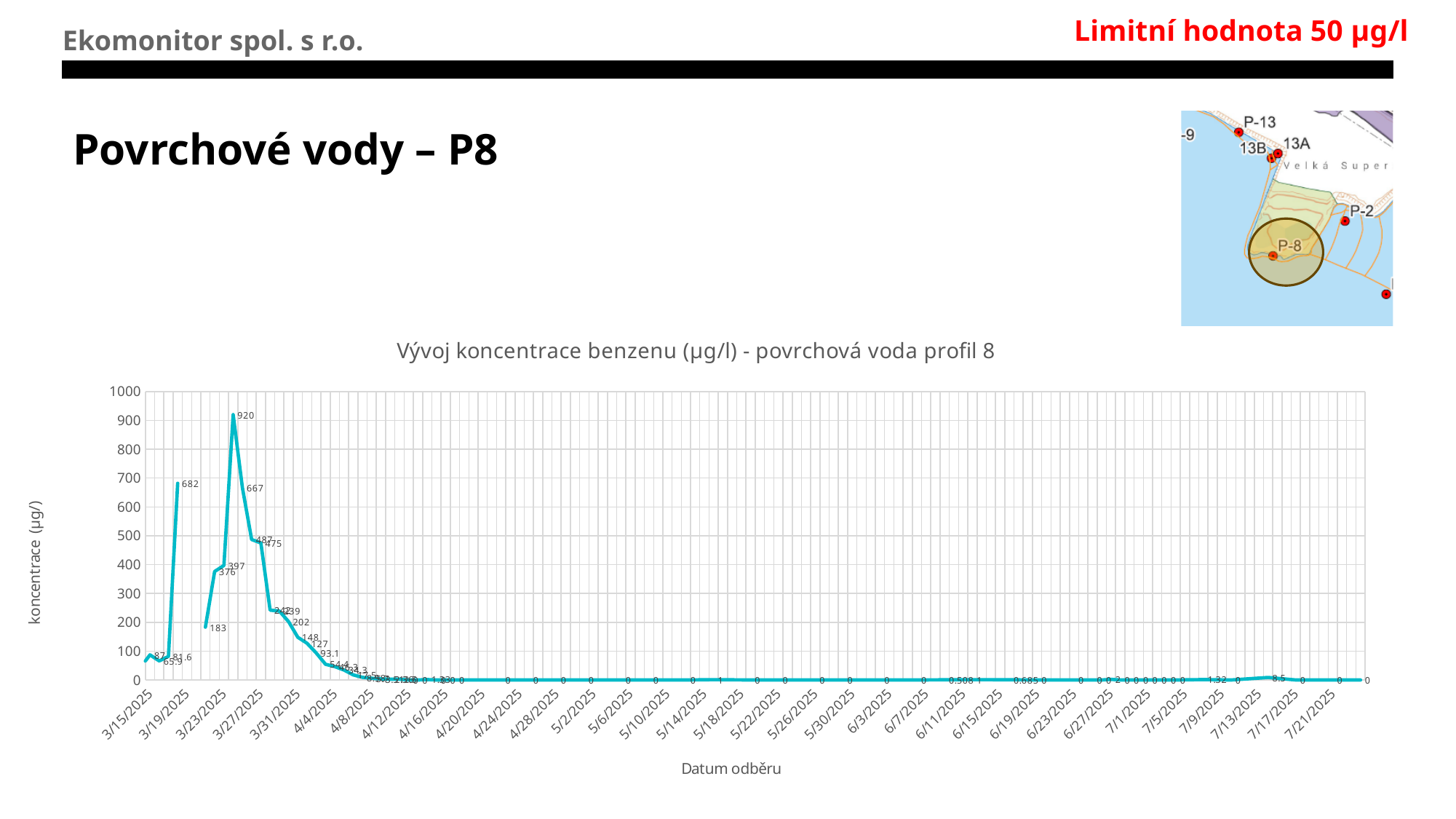
What is the maximum value shown on the vertical axis of the chart? 1000 What type of chart is shown on the slide? line chart Overall, do the concentration values rise or fall along the x axis after the peak in late March 2025? fall What is the difference between the labelled values 487 and 475? 12 Which labelled value is larger: 682 or 667? 682 Is the value on 3/15/2025 greater or less than 100? less What is the title of the chart? Vývoj koncentrace benzenu (µg/l) - povrchová voda profil 8 What is the highest benzene concentration value labelled on the chart? 920 What is the lowest value labelled on the chart? 0 What is the label of the vertical axis of the chart? koncentrace (µg/l) How many data series are plotted on the chart? 1 What is the difference between the peak value of 920 and the value of 682 labelled earlier on the chart? 238